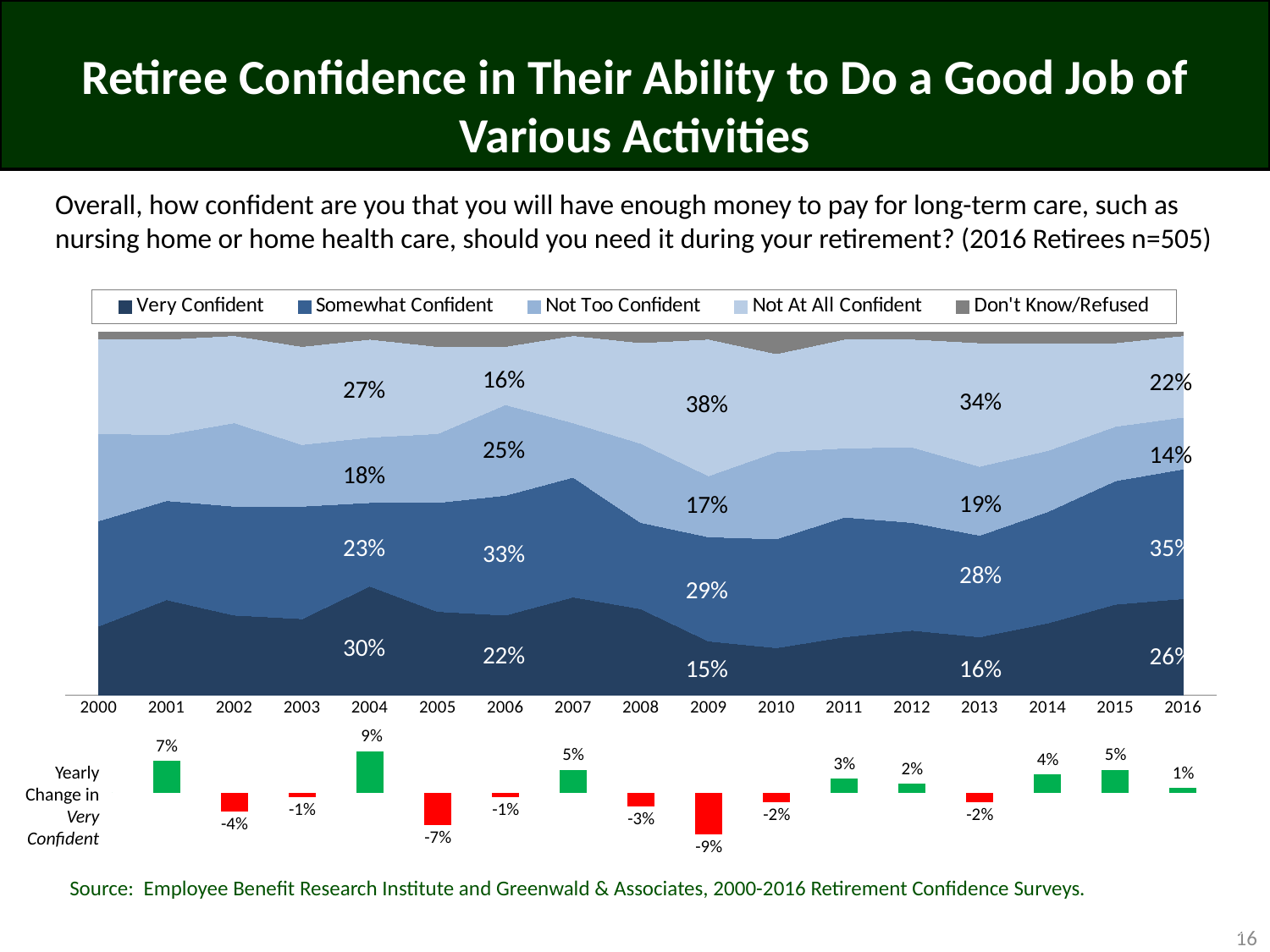
In the bottom 'Yearly Change in Very Confident' bar chart, what is the value for 2015? 5% In the bottom 'Yearly Change in Very Confident' bar chart, how many years are shown? 16 In the top stacked area chart, what is the difference between the Very Confident values for 2004 and 2009? 15% In the top stacked area chart, what percentage of retirees were Not At All Confident in 2009? 38% In the top stacked area chart, how many series does the legend list? 5 In the bottom 'Yearly Change in Very Confident' bar chart, which year has the largest negative change? 2009 In the top stacked area chart, what percentage of retirees were Somewhat Confident in 2016? 35% In the top stacked area chart, which is larger: the Not At All Confident value in 2006 or in 2013? 2013 What kind of chart is the bottom 'Yearly Change in Very Confident' chart? Bar chart In the bottom 'Yearly Change in Very Confident' bar chart, which year has the largest positive change? 2004 In the top stacked area chart, what percentage of retirees were Very Confident in 2004? 30% In the top stacked area chart, what percentage of retirees were Not Too Confident in 2013? 19%